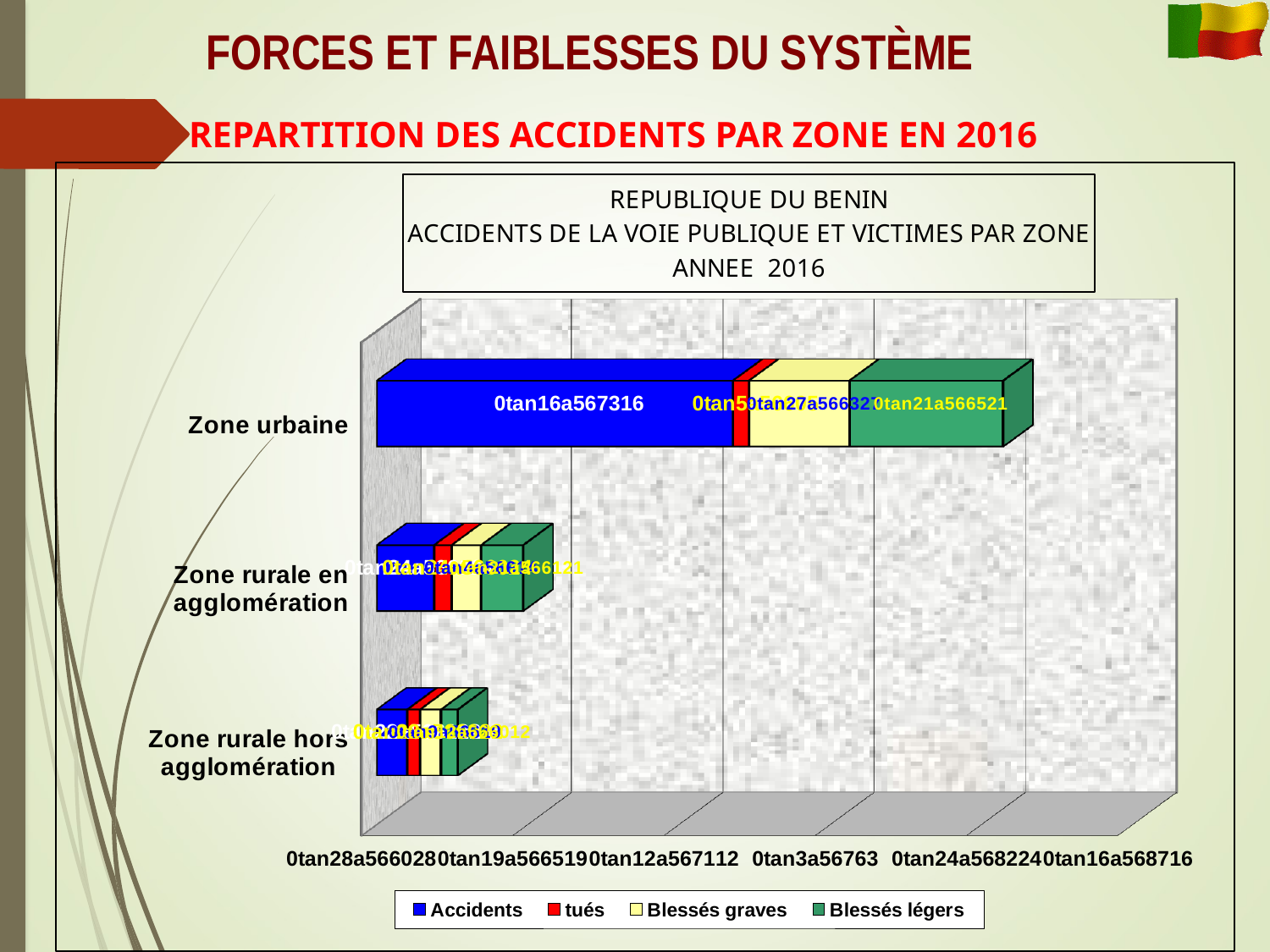
Which series is shown in red in the legend? tués Which zone has the smallest Accidents bar? Zone rurale hors agglomération Which zone has the shortest total stacked bar? Zone rurale hors agglomération Is the Blessés légers bar larger for Zone urbaine or for Zone rurale hors agglomération? Zone urbaine What kind of chart is shown on the slide? bar chart Which zone has the longest total stacked bar? Zone urbaine Is the Accidents bar larger for Zone urbaine or for Zone rurale en agglomération? Zone urbaine Which zone has the largest Accidents bar? Zone urbaine How many zone categories are plotted on the chart? 3 Which series is shown in blue in the legend? Accidents How many series does the legend list? 4